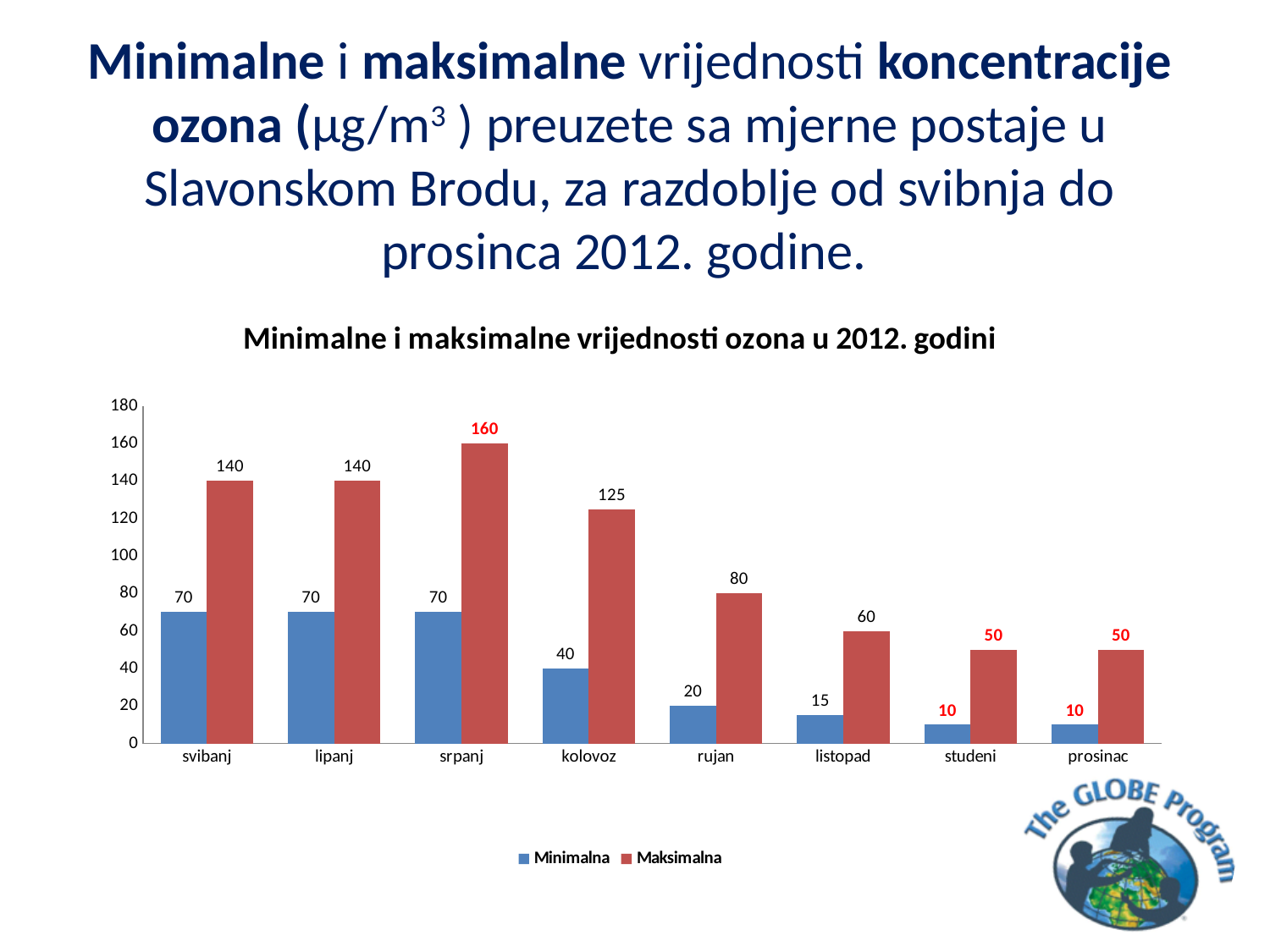
What kind of chart is shown on the slide? bar chart What is the Minimalna value for kolovoz? 40 What is the Maksimalna value for srpanj? 160 Which month has the lowest Maksimalna value? studeni and prosinac What is the difference between the Maksimalna and Minimalna values for kolovoz? 85 Is the Maksimalna value for kolovoz greater or less than 100? greater Which is larger, the Maksimalna value for rujan or the Maksimalna value for listopad? rujan How many months are shown on the x axis? 8 Which month has the highest Maksimalna value? srpanj What is the Maksimalna value for listopad? 60 How many series does the legend list? 2 Do the Minimalna values rise or fall from svibanj to prosinac? fall